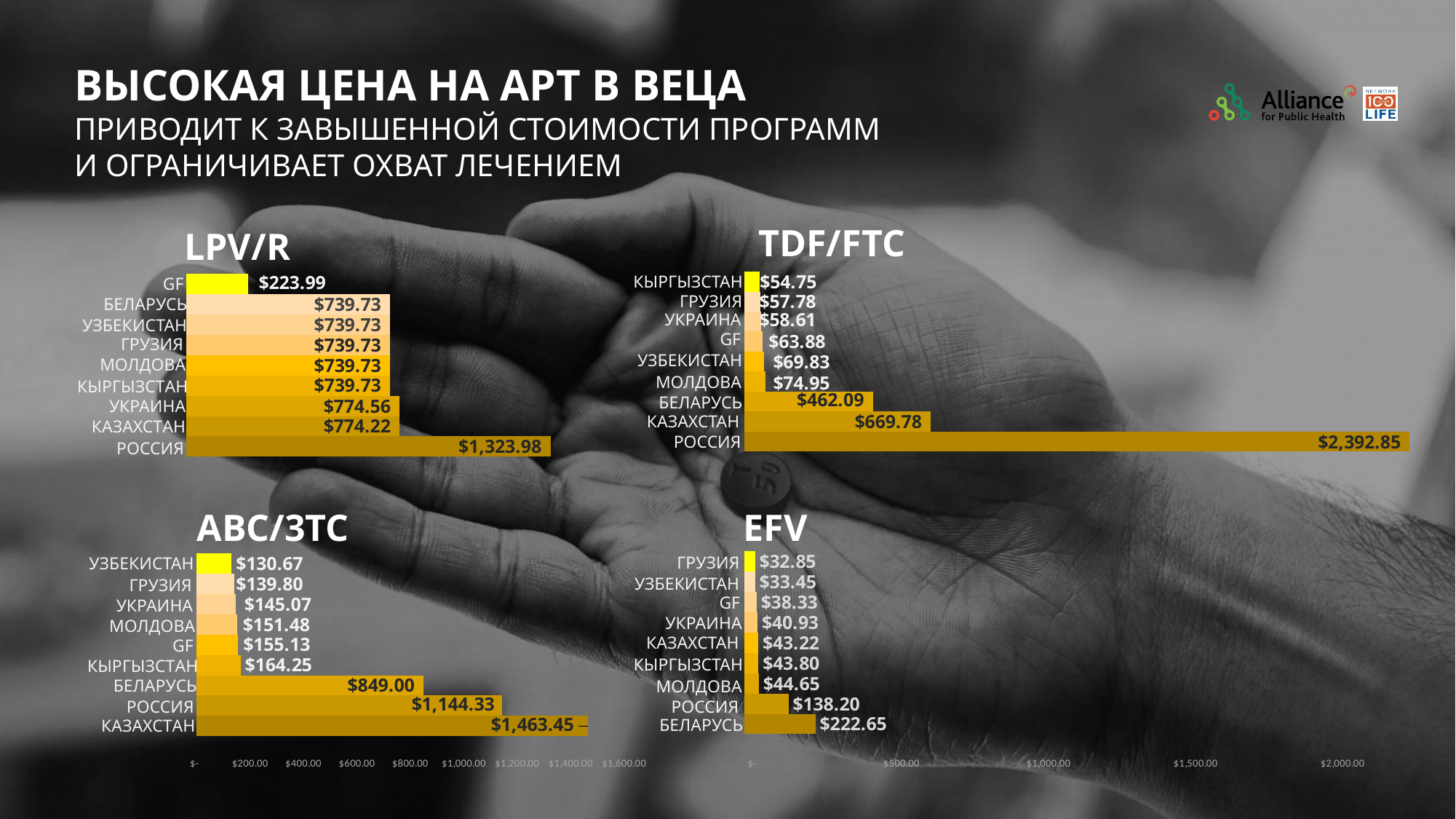
In the ABC/3TC chart, what is the difference between the values for КАЗАХСТАН and РОССИЯ? $319.12 In the TDF/FTC chart, which country has the highest value? РОССИЯ In the TDF/FTC chart, what is the value for КАЗАХСТАН? $669.78 In the ABC/3TC chart, what is the value for БЕЛАРУСЬ? $849.00 In the EFV chart, what is the difference between the values for БЕЛАРУСЬ and РОССИЯ? $84.45 In the LPV/R chart, what is the value for РОССИЯ? $1,323.98 In the TDF/FTC chart, which is larger, the value for БЕЛАРУСЬ or the value for КАЗАХСТАН? КАЗАХСТАН How many categories are shown in the EFV chart? 9 What kind of chart is the ABC/3TC chart? Bar chart In the EFV chart, what is the value for МОЛДОВА? $44.65 In the LPV/R chart, which category has the lowest value? GF How many charts are shown on the slide? 4